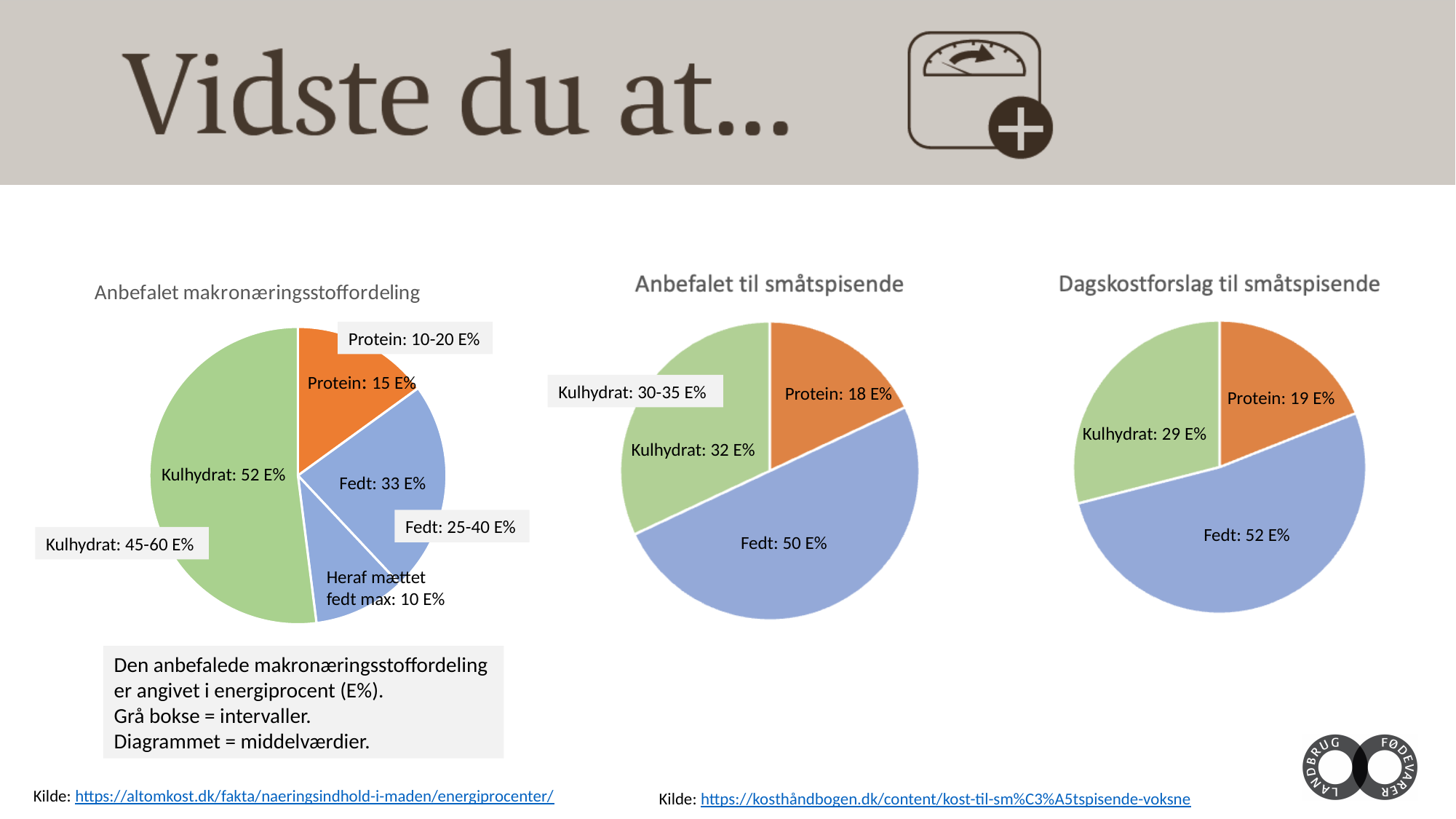
In the chart titled "Anbefalet til småtspisende", what is the value for Fedt? 50 E% What kind of chart is the chart titled "Anbefalet til småtspisende"? pie chart In the chart titled "Anbefalet makronæringsstoffordeling", what interval is given in the grey box for Fedt? 25-40 E% In the chart titled "Dagskostforslag til småtspisende", which category has the largest share? Fedt In the chart titled "Anbefalet makronæringsstoffordeling", what is the value for Protein? 15 E% In the chart titled "Anbefalet makronæringsstoffordeling", what is the maximum value given for Heraf mættet fedt? 10 E% In the chart titled "Dagskostforslag til småtspisende", what is the value for Kulhydrat? 29 E% In the chart titled "Anbefalet til småtspisende", is the value for Kulhydrat larger or smaller than the value for Fedt? smaller In the chart titled "Anbefalet til småtspisende", which category has the smallest share? Protein In the chart titled "Dagskostforslag til småtspisende", what is the difference between Fedt and Protein? 33 E% In the chart titled "Anbefalet makronæringsstoffordeling", which category has the largest share? Kulhydrat In the chart titled "Anbefalet makronæringsstoffordeling", what is the value for Kulhydrat? 52 E%